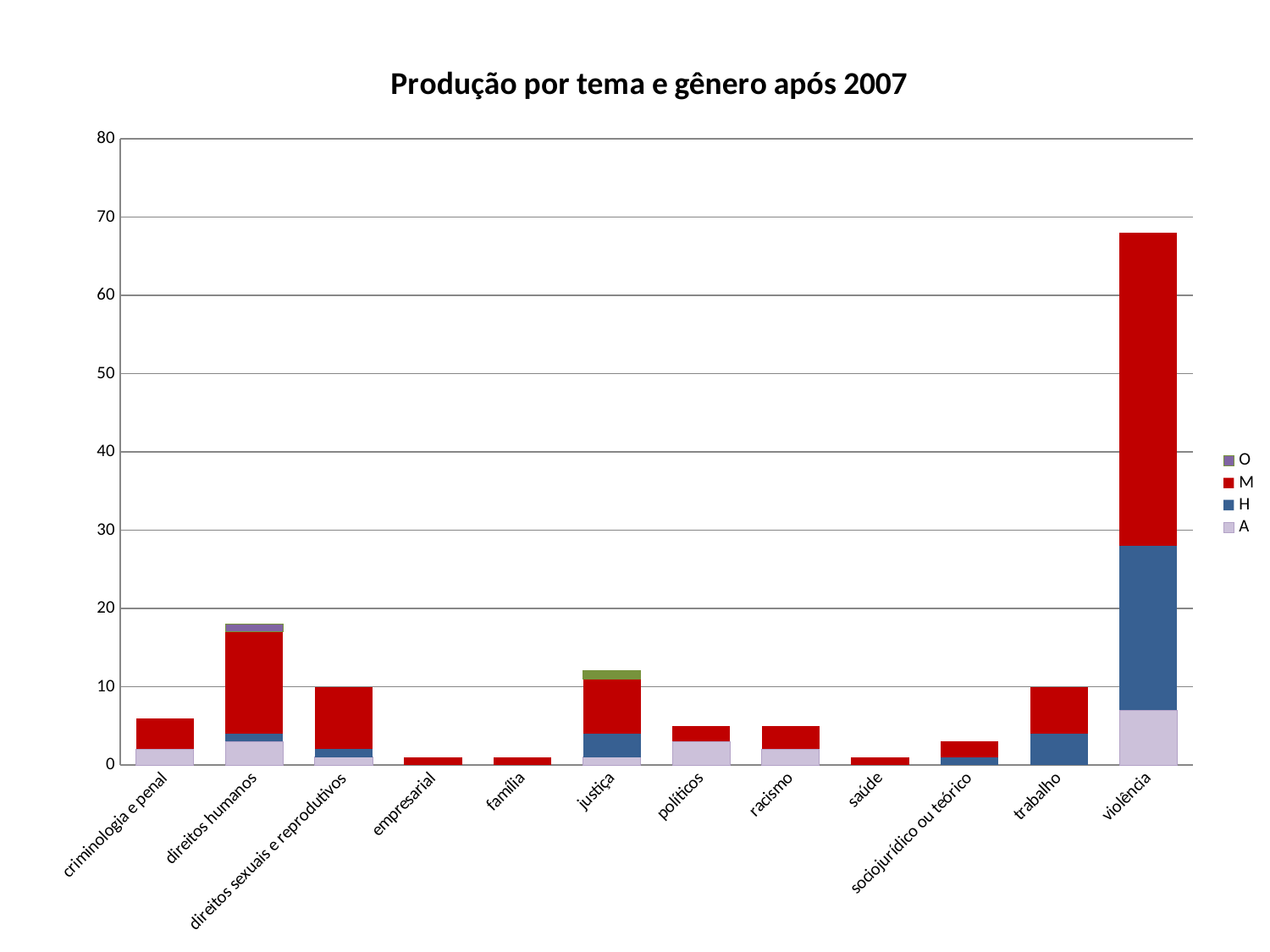
What is the total of the stacked bar for direitos sexuais e reprodutivos? 10 Is the total value for direitos humanos greater or less than 20? less Which category has the highest total bar? violência Which series are listed in the legend? O, M, H, A Is the total value for criminologia e penal greater or less than 10? less How many series does the legend list? 4 How many categories are shown on the x axis? 12 Which has the larger total bar, direitos humanos or justiça? direitos humanos What kind of chart is shown on the slide? stacked bar chart What is the total of the stacked bar for trabalho? 10 What is the title of the chart? Produção por tema e gênero após 2007 Is the total value for violência greater or less than 60? greater